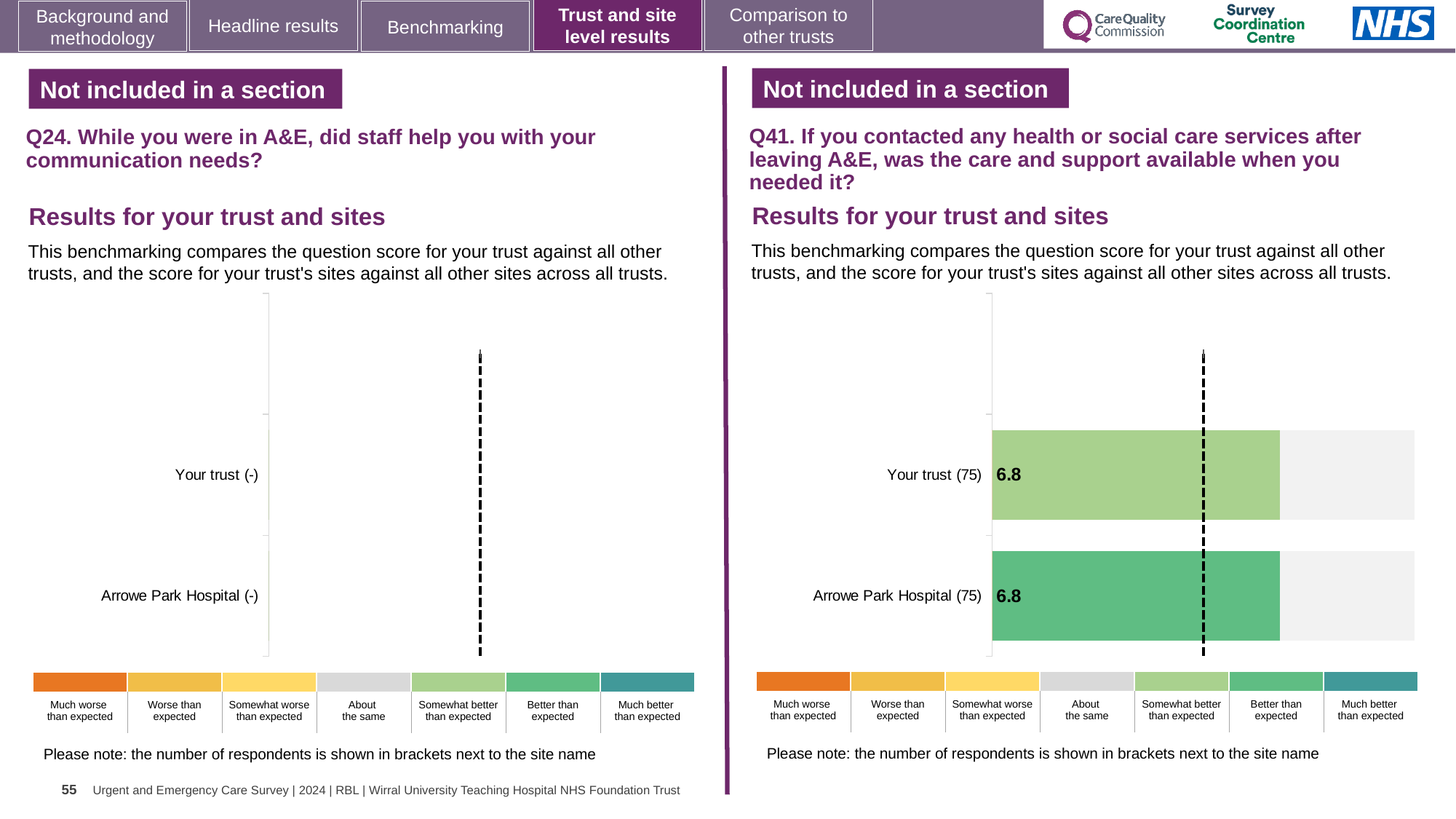
On the Q41 chart, how many categories does the colour key below the chart list? 7 On the Q24 chart, what is shown in brackets next to Arrowe Park Hospital? - On the Q24 chart, how many rows (trust and sites) are listed on the vertical axis? 2 On the Q41 chart, what is the score for Your trust? 6.8 On the Q41 chart, how many respondents are shown in brackets for Your trust? 75 On the Q41 chart, what is the score for Arrowe Park Hospital? 6.8 On the Q41 chart, how many rows (trust and sites) are plotted? 2 What kind of chart is the Q24 chart? bar chart What kind of chart is the Q41 chart? bar chart On the Q41 chart, what is the difference between the score for Your trust and the score for Arrowe Park Hospital? 0.0